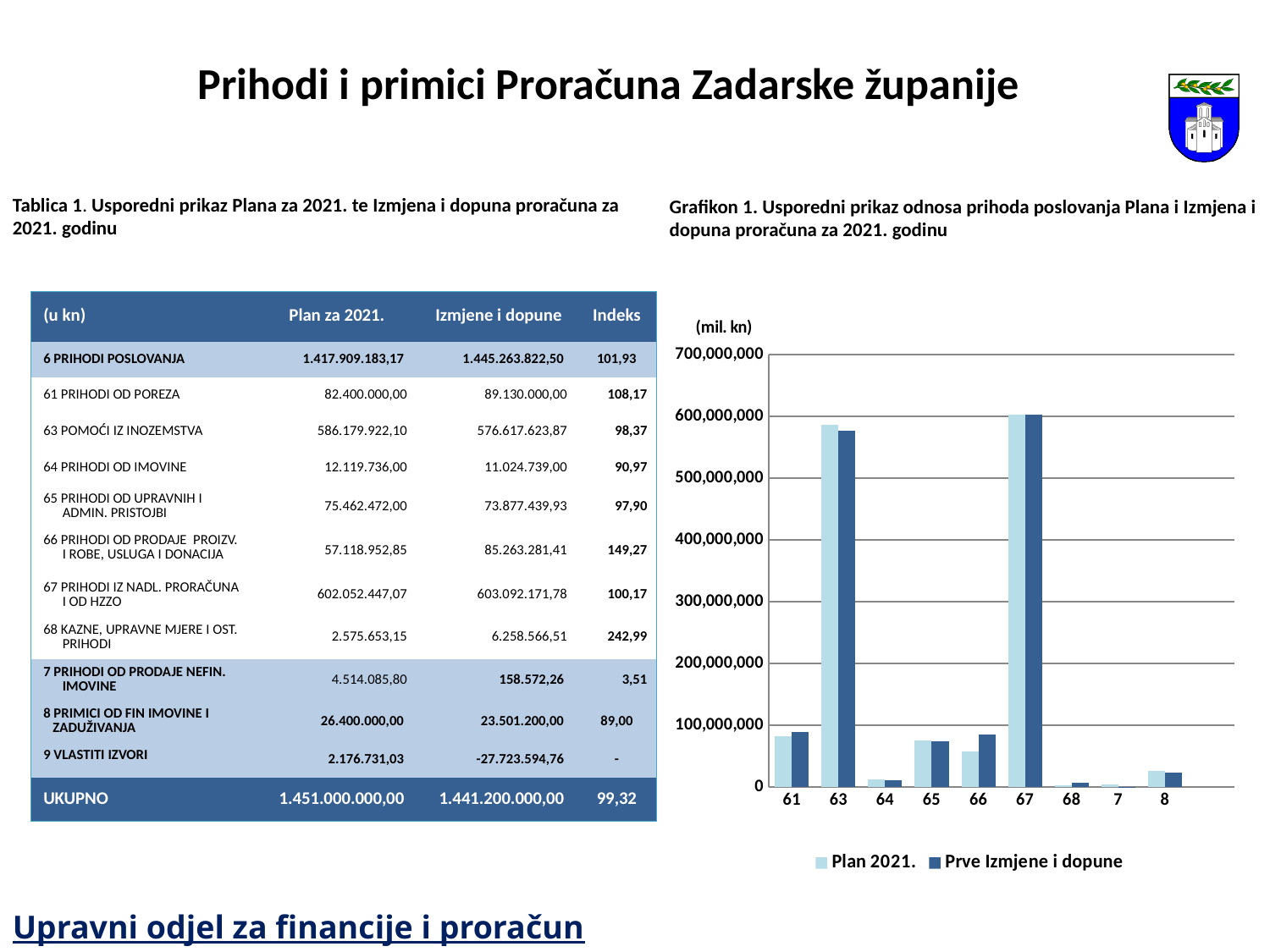
What unit label is shown above the chart's vertical axis? (mil. kn) What kind of chart is Grafikon 1 on the slide? bar chart Is the Prve Izmjene i dopune value for category 64 greater or less than 100,000,000? less Is the Plan 2021. value for category 63 greater or less than 500,000,000? greater Which category has the highest bar for the Prve Izmjene i dopune series? 67 Is the Plan 2021. value for category 61 greater or less than 100,000,000? less For category 66, which series has the larger bar, Plan 2021. or Prve Izmjene i dopune? Prve Izmjene i dopune Which category has the larger Plan 2021. bar, 63 or 61? 63 What are the two series named in the chart's legend? Plan 2021. and Prve Izmjene i dopune Which category has the highest bar for the Plan 2021. series? 67 How many series does the chart's legend list? 2 How many categories are shown on the x axis of the chart? 9